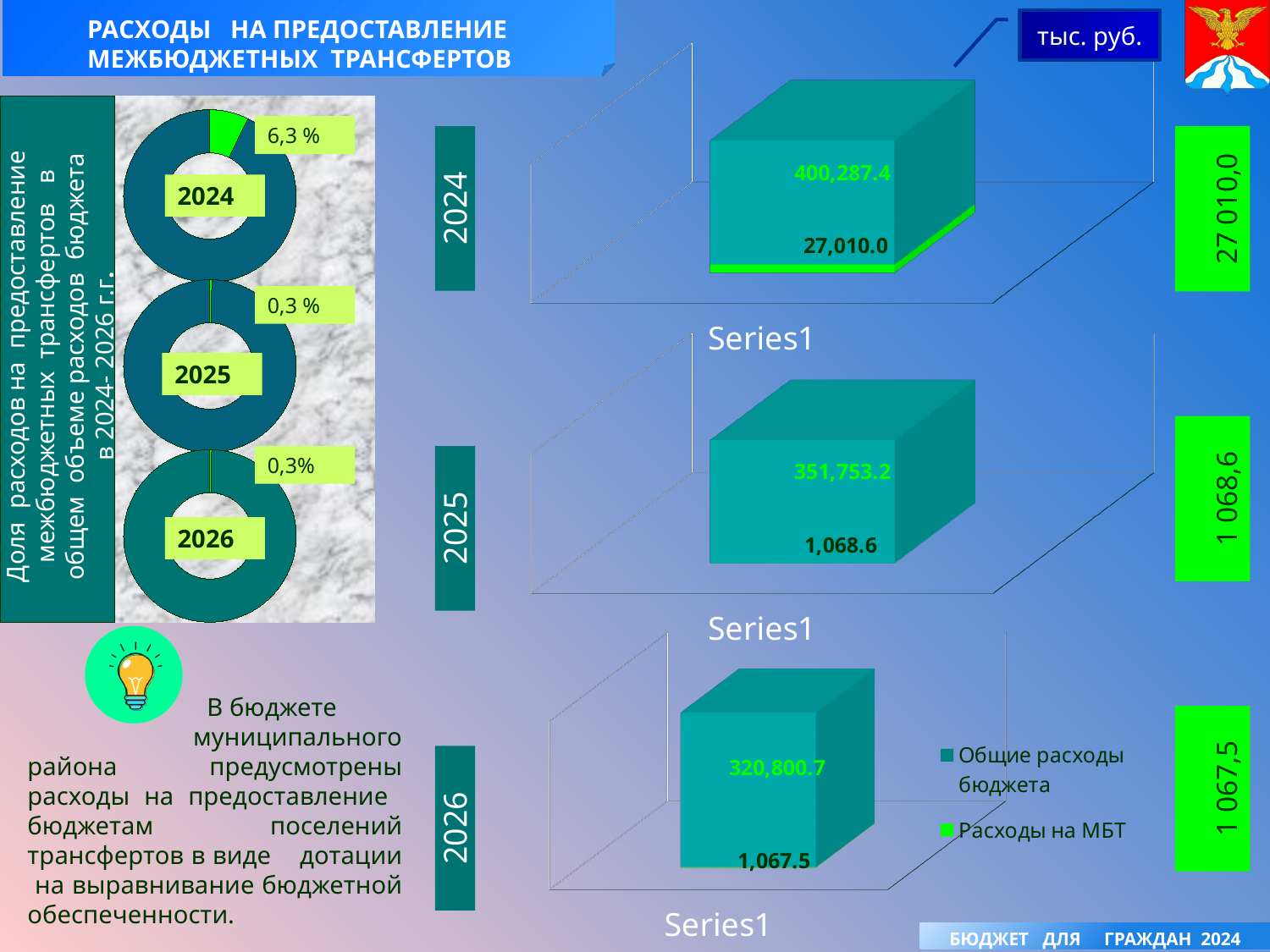
Across the 2024, 2025 and 2026 charts, which year has the highest value for Общие расходы бюджета? 2024 In the 2024 chart, what is the difference between Общие расходы бюджета and Расходы на МБТ? 373,277.4 Across the 2024, 2025 and 2026 charts, which year has the lowest value for Общие расходы бюджета? 2026 In the 2024 chart, what is the value for Общие расходы бюджета? 400,287.4 In the 2025 chart, what is the value for Общие расходы бюджета? 351,753.2 In the 2024 donut chart on the left, what share of total budget expenses do intergovernmental transfers make up? 6,3 % In the 2026 chart, what is the value for Общие расходы бюджета? 320,800.7 In the 2026 chart, what is the value for Расходы на МБТ? 1,067.5 In the 2024 chart, what is the value for Расходы на МБТ? 27,010.0 How many series does the legend of the bar charts list? 2 In the 2025 chart, what is the value for Расходы на МБТ? 1,068.6 In the 2025 donut chart on the left, what share of total budget expenses do intergovernmental transfers make up? 0,3 %